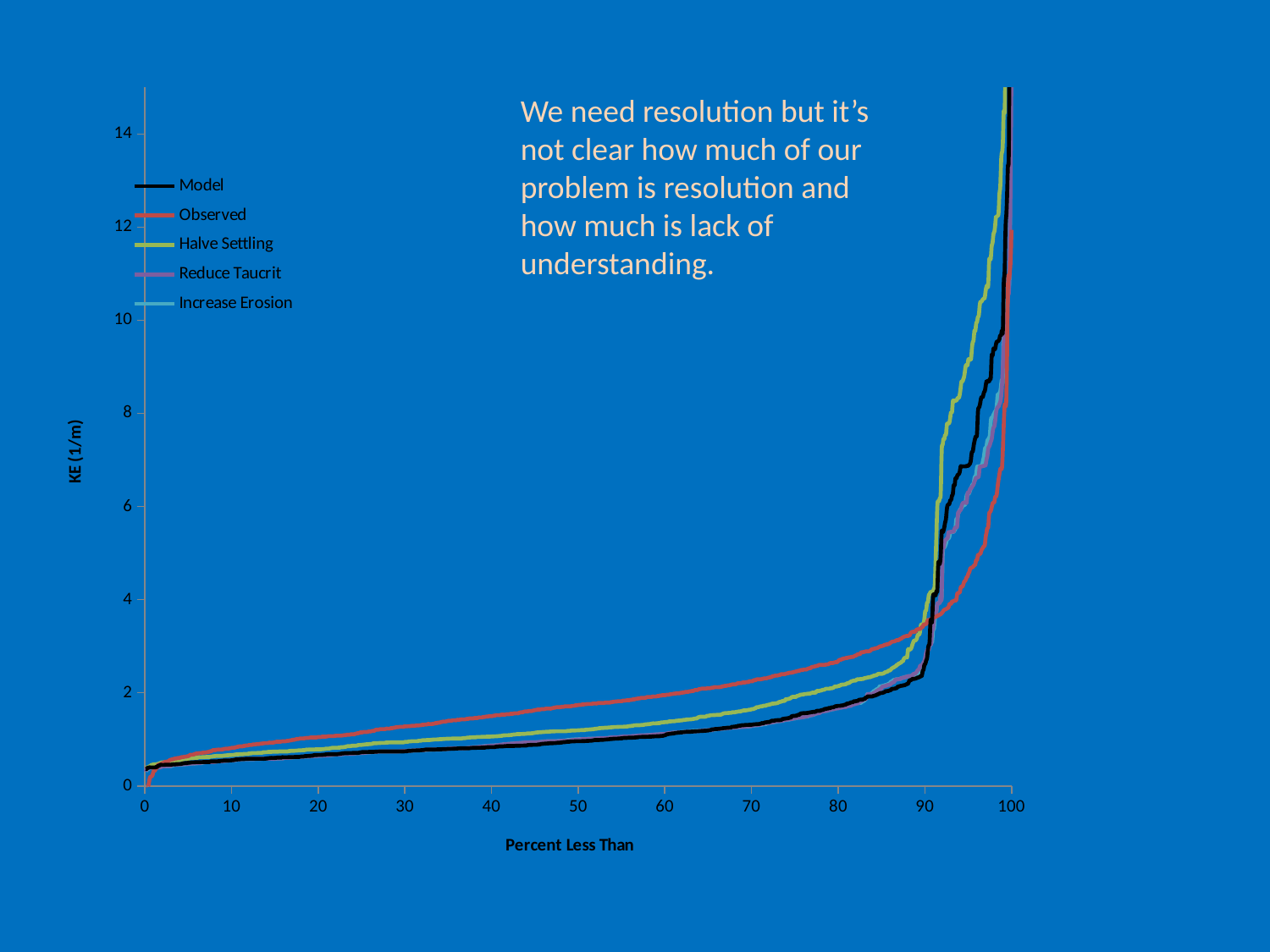
Is the value of the Observed series at Percent Less Than 50 greater or less than 2? less What kind of chart is shown on the slide? line chart Is the value of the Model series at Percent Less Than 50 greater or less than 2? less At Percent Less Than 95, which series has the higher value, Halve Settling or Observed? Halve Settling What is the title of the y axis? KE (1/m) Do the values of the Model series rise or fall as Percent Less Than increases? rise Is the value of the Observed series at Percent Less Than 80 greater or less than 2? greater At Percent Less Than 50, which series has the higher value, Observed or Model? Observed How many series does the legend list? 5 At Percent Less Than 30, which series has the higher value, Observed or Halve Settling? Observed What is the title of the x axis? Percent Less Than